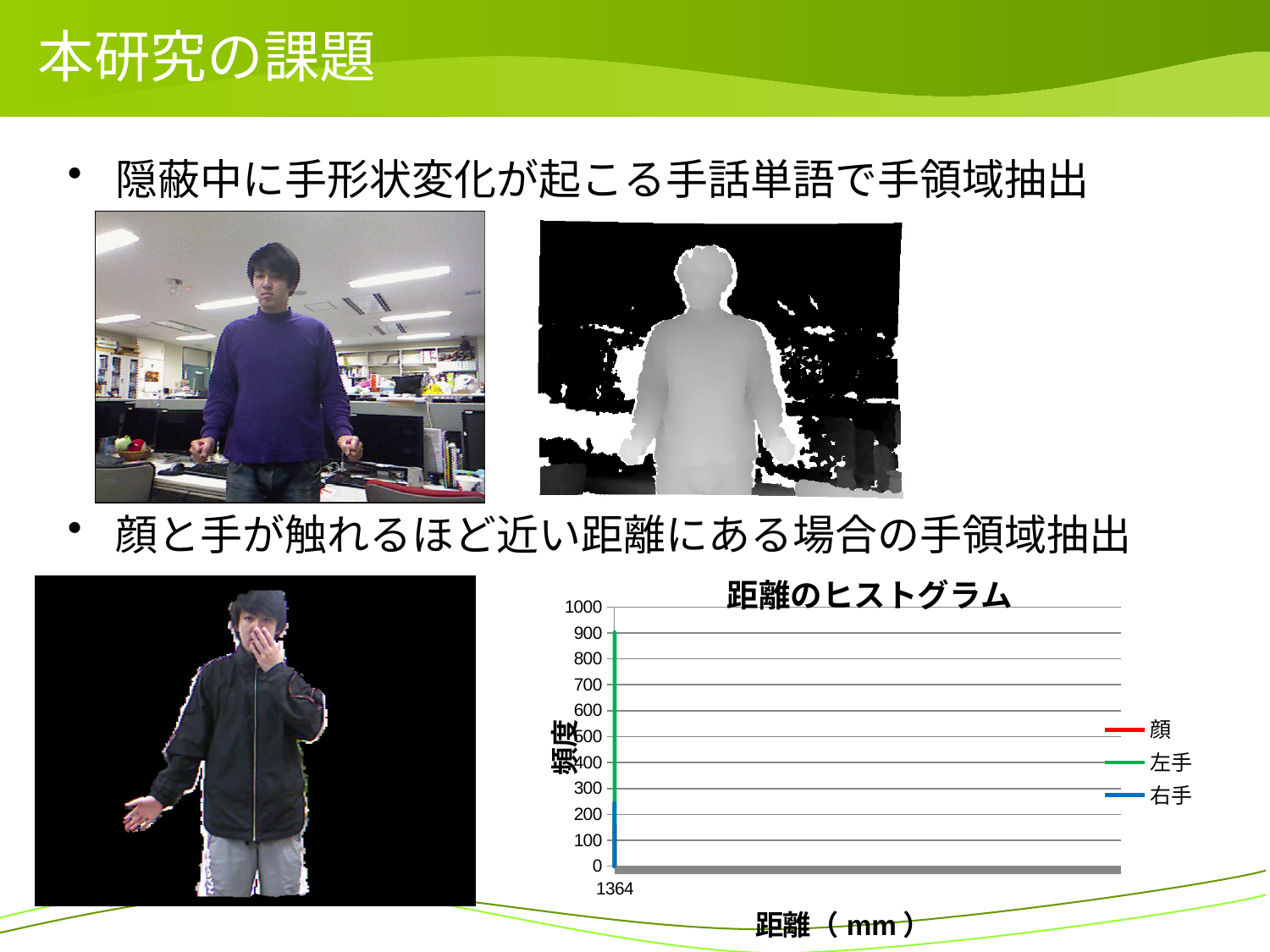
What is the title of the chart on the slide? 距離のヒストグラム What kind of chart is the 距離のヒストグラム chart? line chart In the 距離のヒストグラム chart, which series reaches the highest peak? 左手 In the 距離のヒストグラム chart, is the peak value of 右手 greater or less than 500? less What is the x-axis tick label shown on the 距離のヒストグラム chart? 1364 Which series in the 距離のヒストグラム chart is drawn in green? 左手 In the 距離のヒストグラム chart, which series has a higher peak, 左手 or 右手? 左手 How many series does the legend of the 距離のヒストグラム chart list? 3 In the 距離のヒストグラム chart, is the peak value of 右手 greater or less than 100? greater In the 距離のヒストグラム chart, is the peak value of 左手 greater or less than 800? greater What is the maximum value shown on the y axis of the 距離のヒストグラム chart? 1000